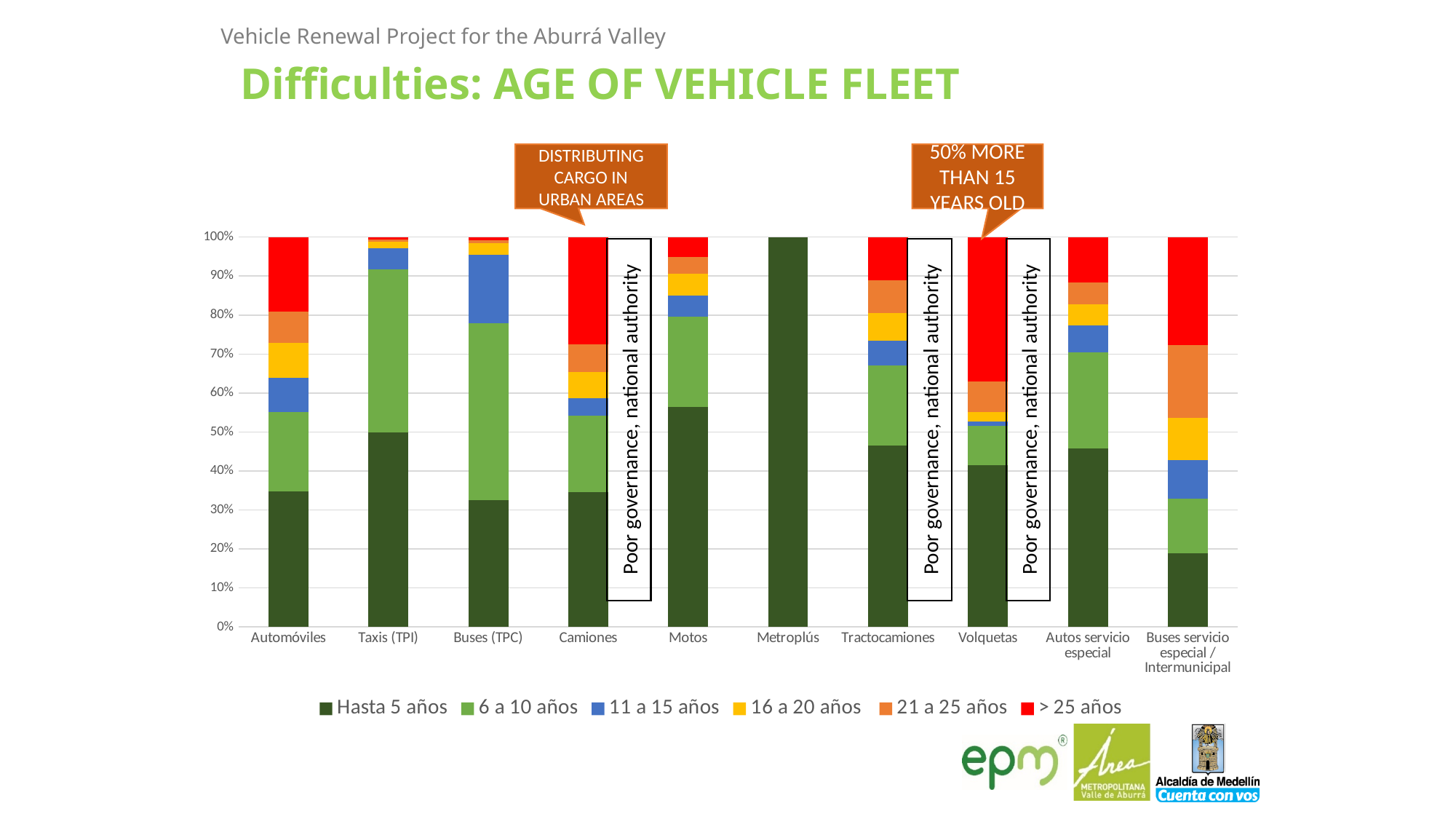
Which has a larger '> 25 años' share, Volquetas or Camiones? Volquetas Which vehicle category has the largest '> 25 años' share? Volquetas What colour represents the '> 25 años' series in the legend? Red What share of the Metroplús fleet is in the 'Hasta 5 años' category? 100% Which vehicle category has the largest 'Hasta 5 años' share? Metroplús Which vehicle category has the smallest 'Hasta 5 años' share? Buses servicio especial / Intermunicipal Is the 'Hasta 5 años' share for Buses servicio especial / Intermunicipal greater or less than 30%? less Which has a larger 'Hasta 5 años' share, Motos or Automóviles? Motos What kind of chart is shown on the slide? Stacked bar chart How many vehicle categories are shown on the x axis? 10 Is the 'Hasta 5 años' share for Automóviles greater or less than 30%? greater How many series does the legend list? 6